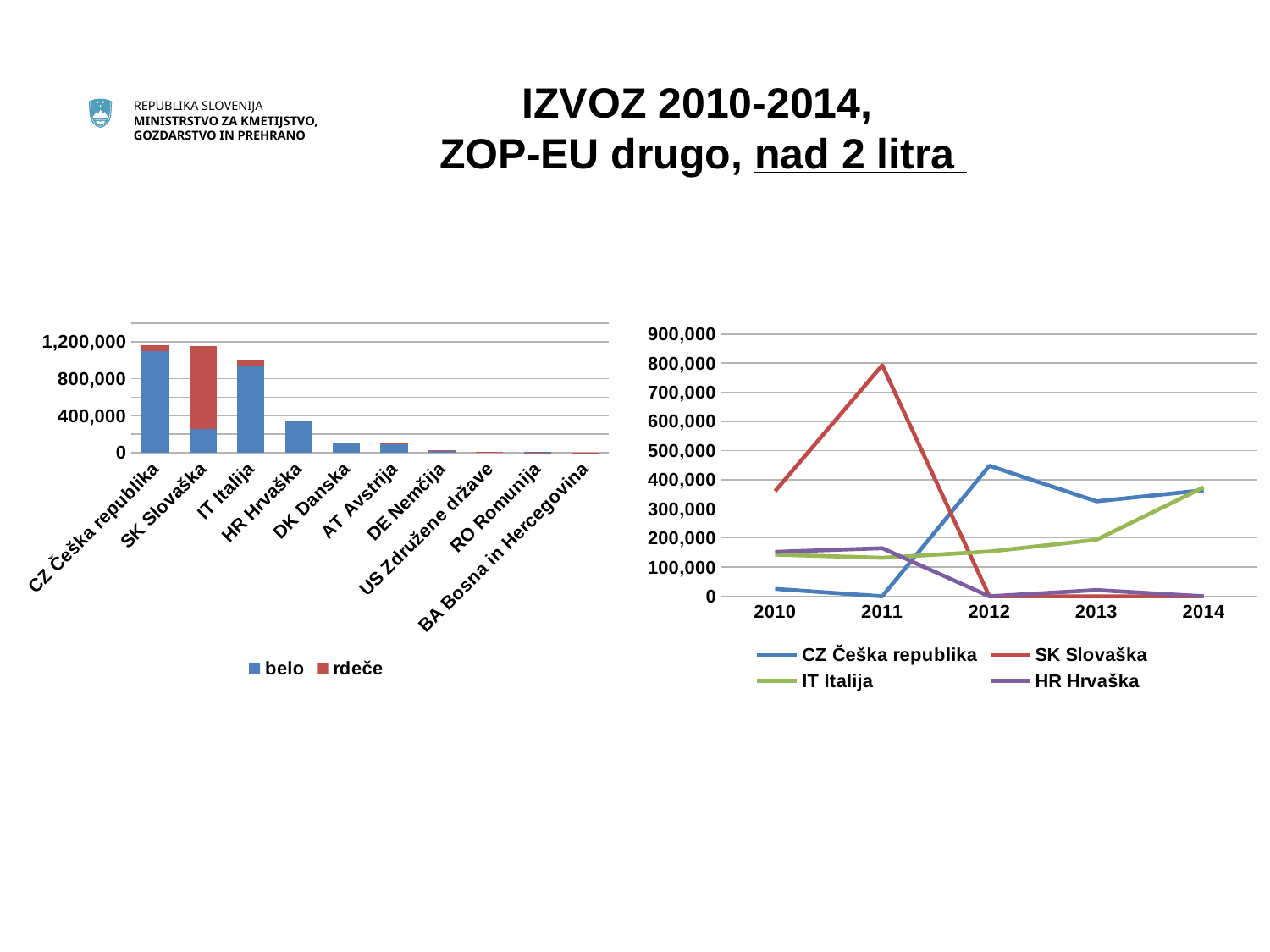
What kind of chart is the chart on the right of the slide? line chart In the left bar chart, is the total value for IT Italija greater or less than 800,000? greater In the left bar chart, is the total value for HR Hrvaška greater or less than 400,000? less How many series does the legend of the left bar chart list? 2 In the right line chart, does the value for IT Italija rise or fall from 2012 to 2014? rise In the left bar chart, which country has the larger rdeče (red) segment, CZ Češka republika or SK Slovaška? SK Slovaška How many countries are shown on the x axis of the left bar chart? 10 In the right line chart, is the value for SK Slovaška in 2011 greater or less than 700,000? greater In the left bar chart, which has the larger total value, IT Italija or HR Hrvaška? IT Italija How many series does the legend of the right line chart list? 4 In the right line chart, in which year does SK Slovaška reach its highest value? 2011 What kind of chart is the chart on the left of the slide? bar chart